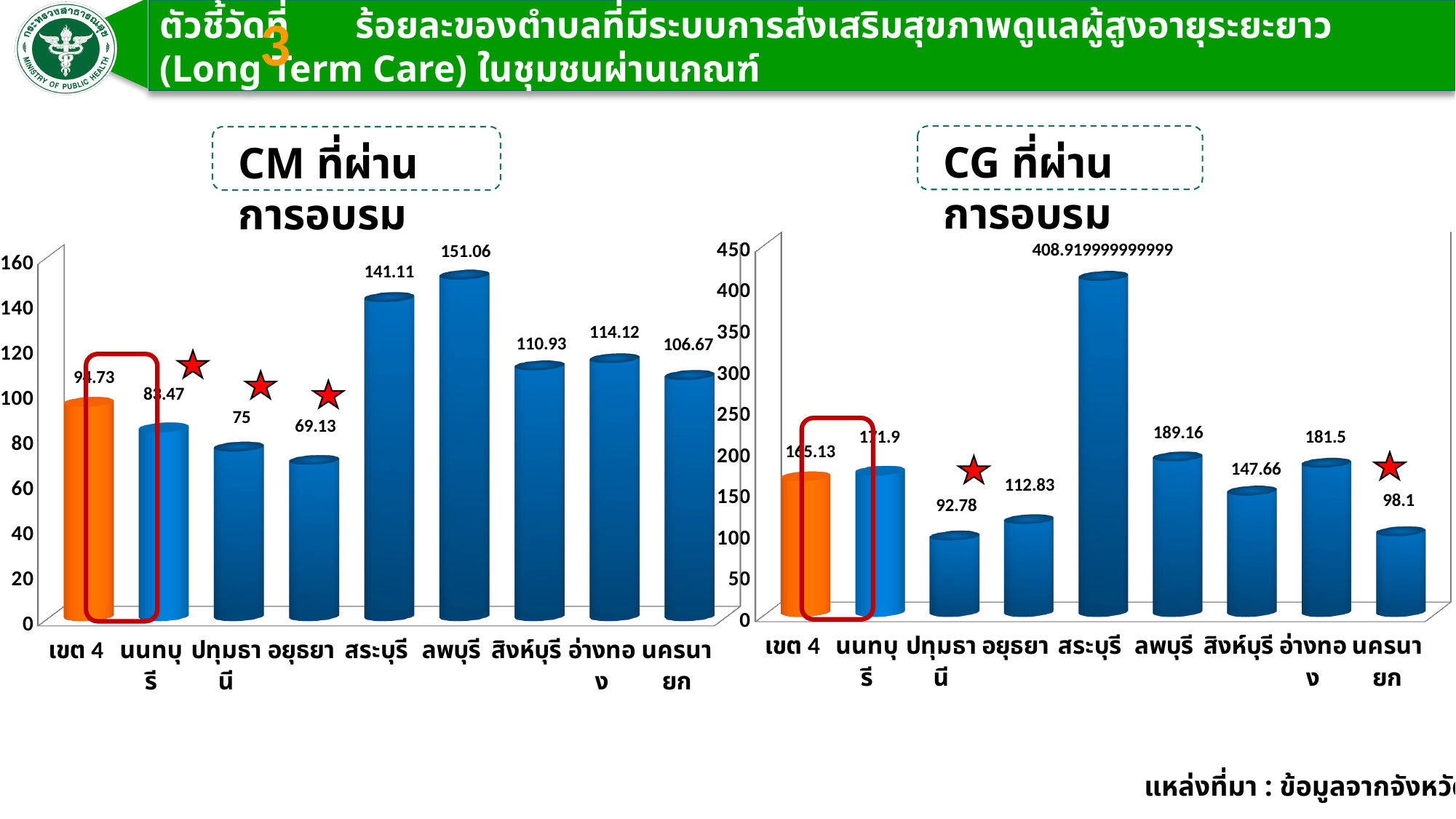
In the left chart (CM ที่ผ่านการอบรม), what is the value for อยุธยา? 69.13 In the right chart (CG ที่ผ่านการอบรม), what is the value for นครนายก? 98.1 In the left chart (CM ที่ผ่านการอบรม), which is larger, the value for อ่างทอง or the value for นครนายก? อ่างทอง In the right chart (CG ที่ผ่านการอบรม), what is the value for สระบุรี? 408.919999999999 In the left chart (CM ที่ผ่านการอบรม), which province has the lowest value? อยุธยา In the left chart (CM ที่ผ่านการอบรม), what is the value for ลพบุรี? 151.06 In the right chart (CG ที่ผ่านการอบรม), what is the difference between the values for ลพบุรี and อ่างทอง? 7.66 In the left chart (CM ที่ผ่านการอบรม), what is the difference between the values for สระบุรี and ปทุมธานี? 66.11 How many categories are shown on the x axis of the right chart (CG ที่ผ่านการอบรม)? 9 In the left chart (CM ที่ผ่านการอบรม), which province has the highest value? ลพบุรี What type of chart is the left chart (CM ที่ผ่านการอบรม)? Bar chart In the right chart (CG ที่ผ่านการอบรม), which province has the lowest value? ปทุมธานี